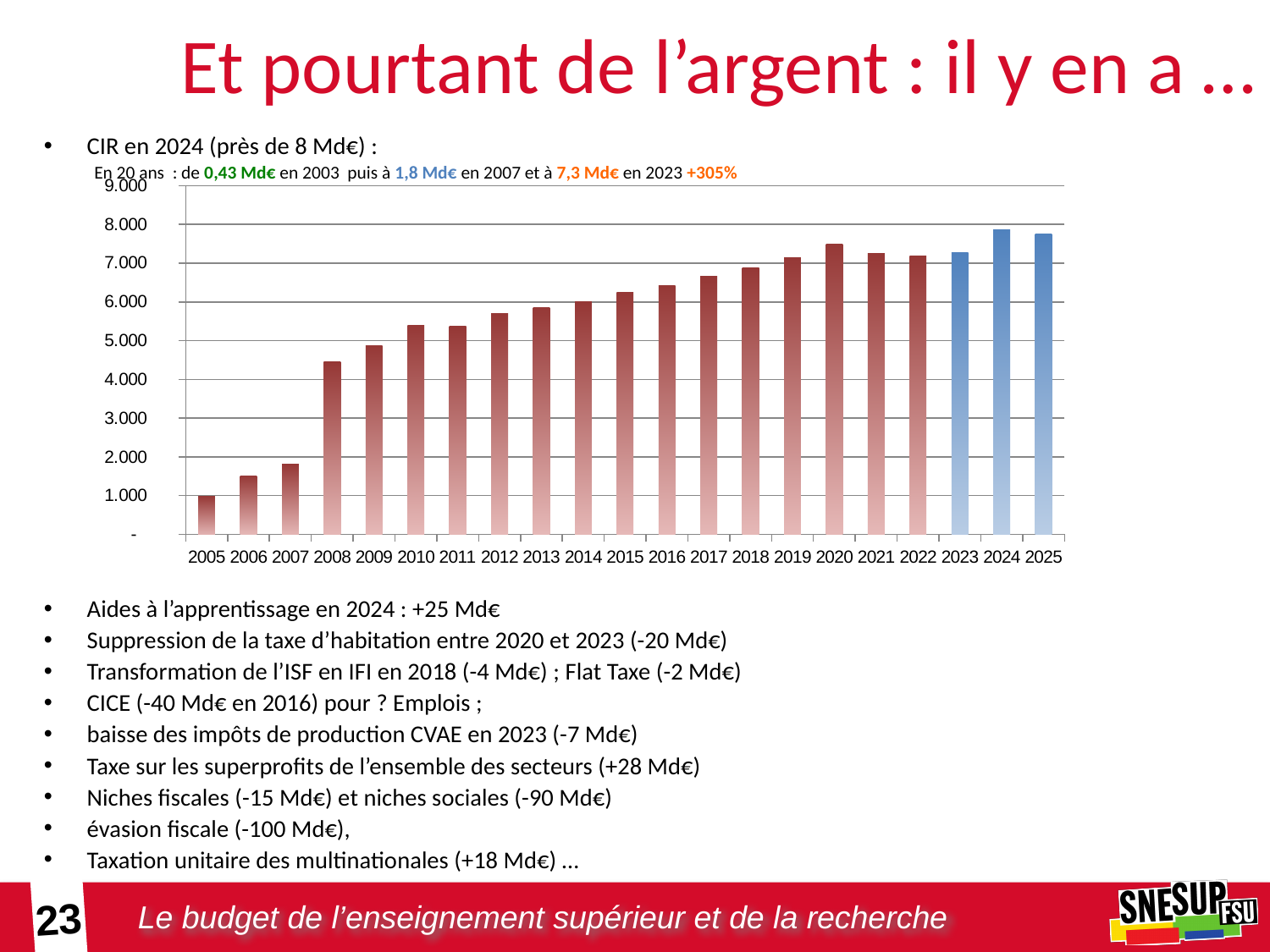
Is the value for 2007 greater or less than 2.000? less Do the values generally rise or fall from 2005 to 2025? rise Which is larger, the value for 2020 or the value for 2021? 2020 Is the value for 2020 greater or less than 7.000? greater Is the value for 2012 greater or less than 6.000? less Which year has the highest bar on the chart? 2024 What kind of chart is shown on the slide? bar chart How many years (bars) are plotted on the chart? 21 Which years are shown with blue bars instead of red bars? 2023, 2024 and 2025 Which year has the lowest bar on the chart? 2005